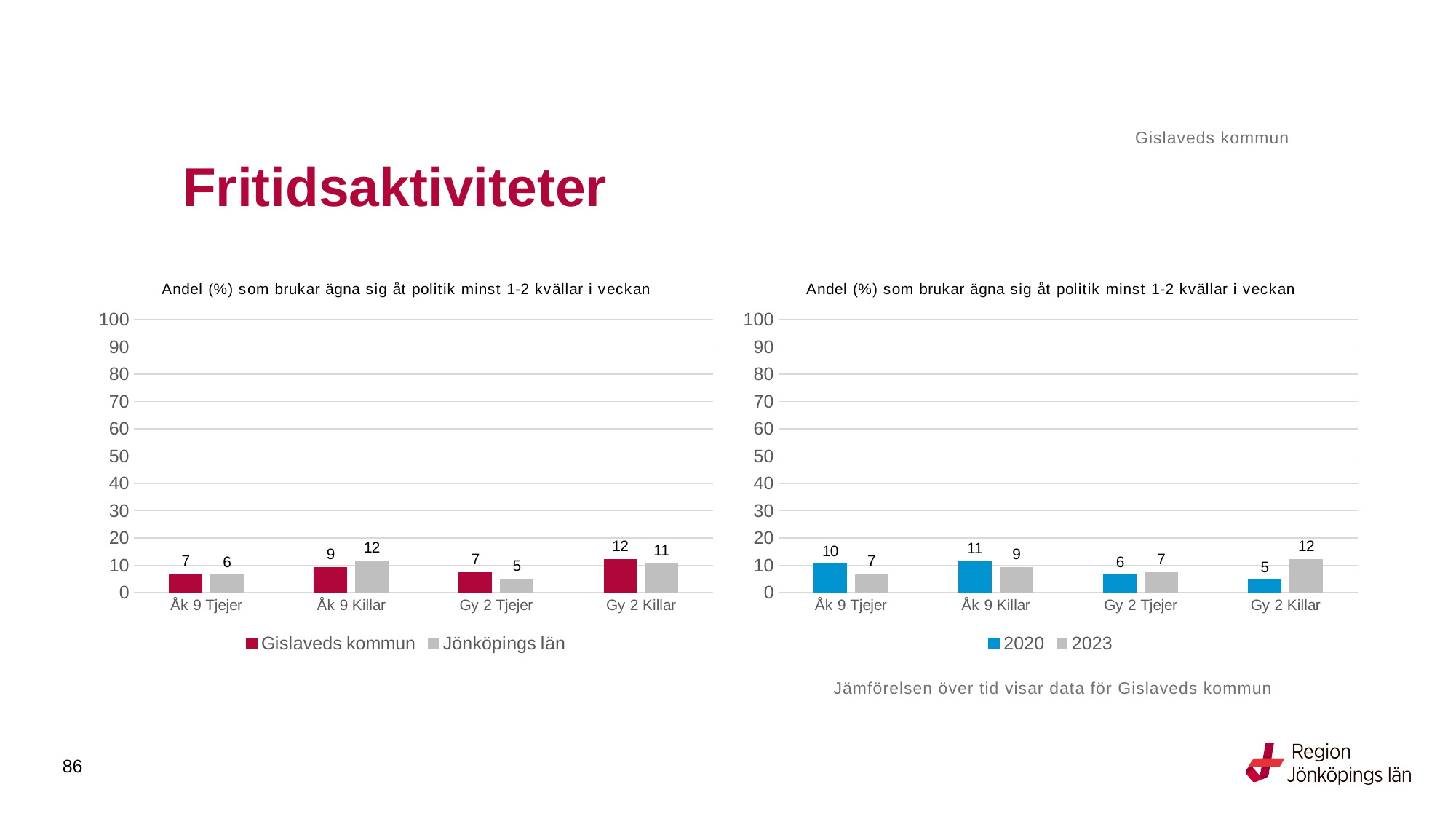
In the right chart, which category has the highest value for 2020? Åk 9 Killar How many categories are shown on the x axis of the right chart? 4 What type of chart is the left chart? Bar chart In the left chart, which category has the lowest value for Jönköpings län? Gy 2 Tjejer In the right chart, which is larger for Gy 2 Killar: 2020 or 2023? 2023 In the left chart, what is the value for Gislaveds kommun for Gy 2 Killar? 12 In the right chart, what is the difference between 2020 and 2023 for Gy 2 Killar? 7 In the left chart, how many series does the legend list? 2 In the right chart, what is the value for 2023 for Gy 2 Killar? 12 In the left chart, what is the difference between Gislaveds kommun and Jönköpings län for Åk 9 Killar? 3 In the left chart, what is the value for Jönköpings län for Åk 9 Killar? 12 In the right chart, what is the value for 2020 for Åk 9 Tjejer? 10